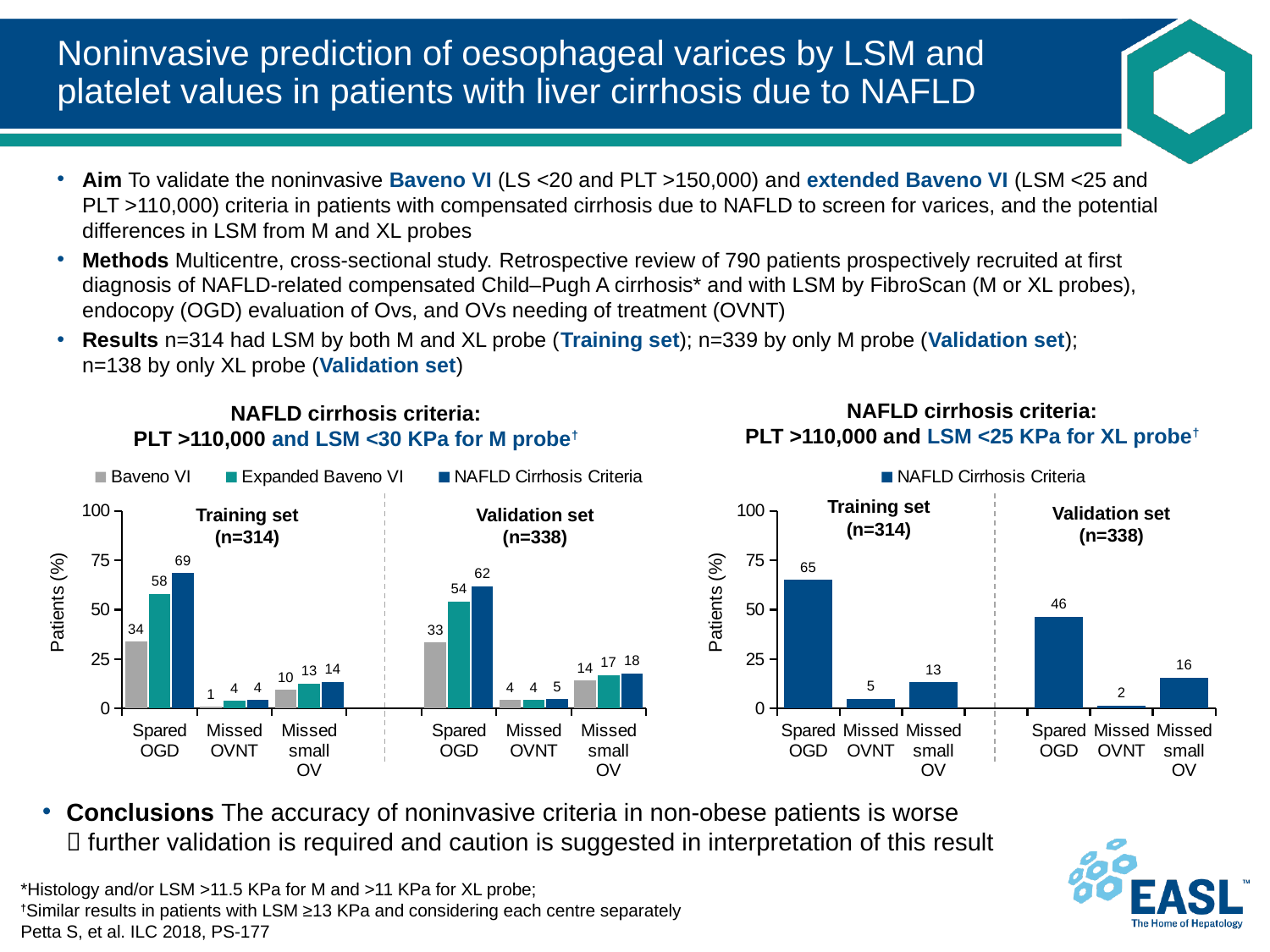
In the left chart (M probe), is the Baveno VI value for Missed small OV in the Validation set larger or smaller than the Baveno VI value for Missed small OV in the Training set? larger In the left chart (M probe), what is the difference between Expanded Baveno VI and Baveno VI for Spared OGD in the Training set? 24 In the left chart (M probe), what is the value for NAFLD Cirrhosis Criteria for Spared OGD in the Training set? 69 In the left chart (M probe), which series has the highest value for Spared OGD in the Validation set? NAFLD Cirrhosis Criteria In the right chart (XL probe), what is the value for Missed OVNT in the Training set? 5 How many series does the legend of the left chart (M probe) list? 3 In the right chart (XL probe), what is the difference between Spared OGD in the Training set and Spared OGD in the Validation set? 19 In the right chart (XL probe), which category has the lowest value in the Validation set? Missed OVNT In the right chart (XL probe), is the value for Spared OGD in the Training set greater or less than 50? greater What kind of chart is the right chart (XL probe)? bar chart In the right chart (XL probe), what is the value for Spared OGD in the Validation set? 46 In the left chart (M probe), what is the value for Baveno VI for Spared OGD in the Validation set? 33